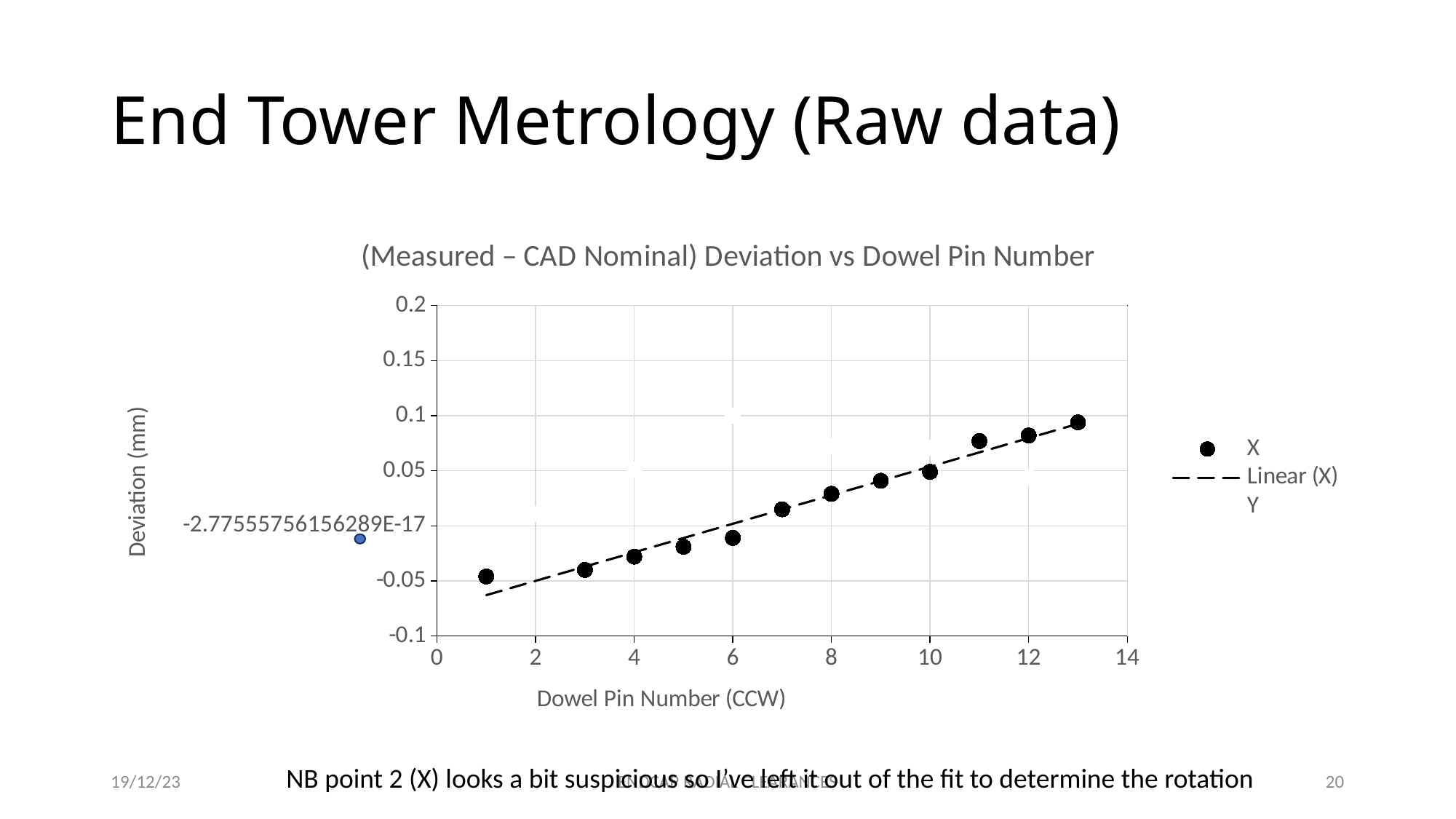
Which dowel pin number has the highest deviation? 13 Is the deviation for dowel pin 6 greater or less than 0? less Which dowel pin number has the lowest deviation? 1 What is the title of the chart? (Measured – CAD Nominal) Deviation vs Dowel Pin Number How many black data points are plotted for the X series? 12 How many entries does the chart legend list? 3 What kind of chart is shown on the slide? scatter chart What is the label of the x axis? Dowel Pin Number (CCW) Which has the larger deviation, dowel pin 9 or dowel pin 4? dowel pin 9 Is the deviation for dowel pin 1 greater or less than 0? less Is the deviation for dowel pin 13 greater or less than 0.05? greater Do the deviation values rise or fall as the dowel pin number increases? rise